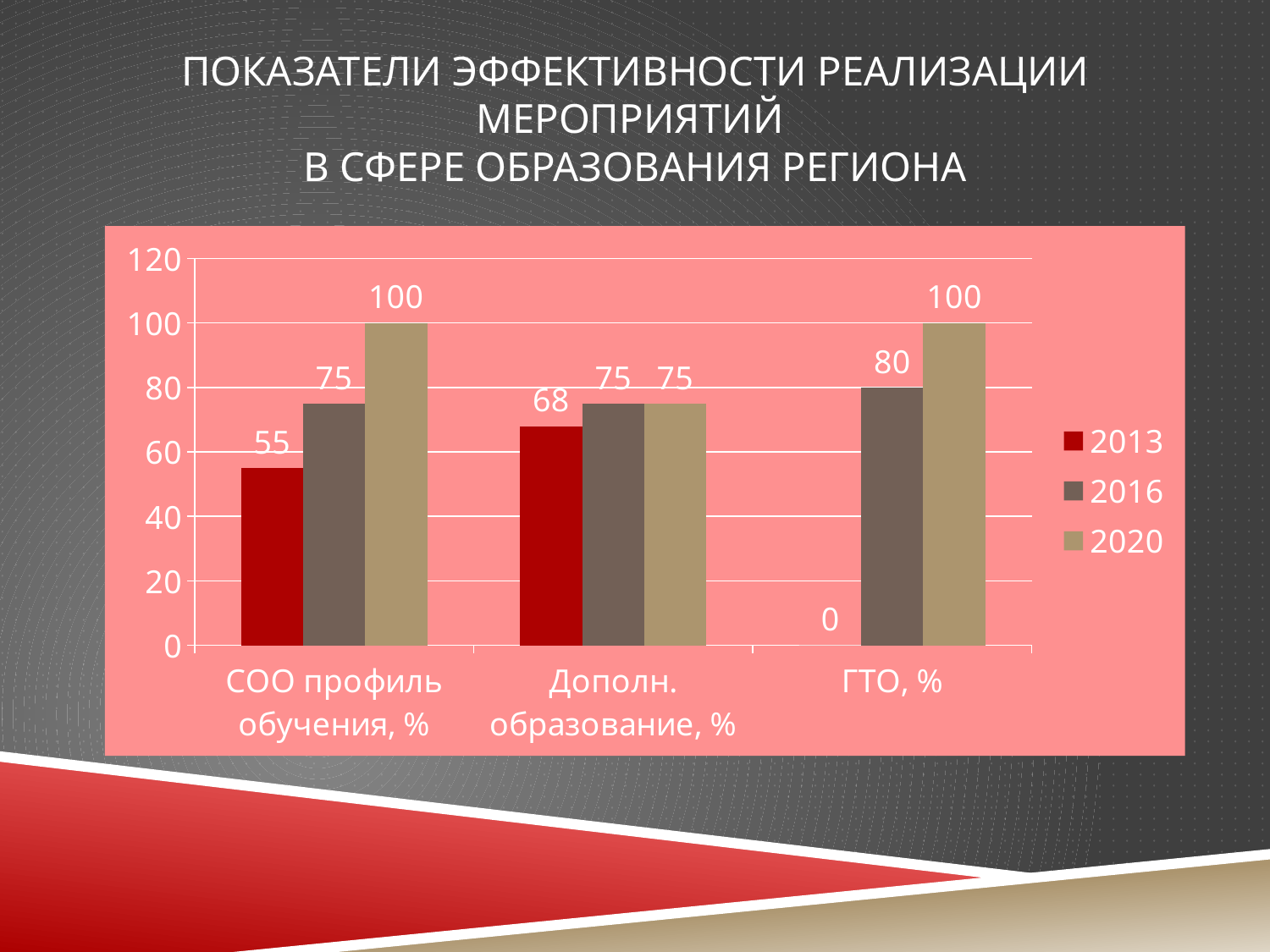
How many series does the legend list? 3 What is the value for 2016 in the 'Дополн. образование, %' category? 75 How many categories are shown on the x axis? 3 Do the values for 'СОО профиль обучения, %' rise or fall from 2013 to 2020? Rise What is the difference between the 2020 and 2013 values in the 'СОО профиль обучения, %' category? 45 What is the value for 2013 in the 'ГТО, %' category? 0 What is the value for 2020 in the 'ГТО, %' category? 100 Which is larger: the 2016 value for 'ГТО, %' or the 2016 value for 'СОО профиль обучения, %'? ГТО, % Which category has the highest value for the 2013 series? Дополн. образование, % Which category has the lowest value for the 2020 series? Дополн. образование, % What kind of chart is shown on the slide? Bar chart What is the value for 2013 in the 'СОО профиль обучения, %' category? 55